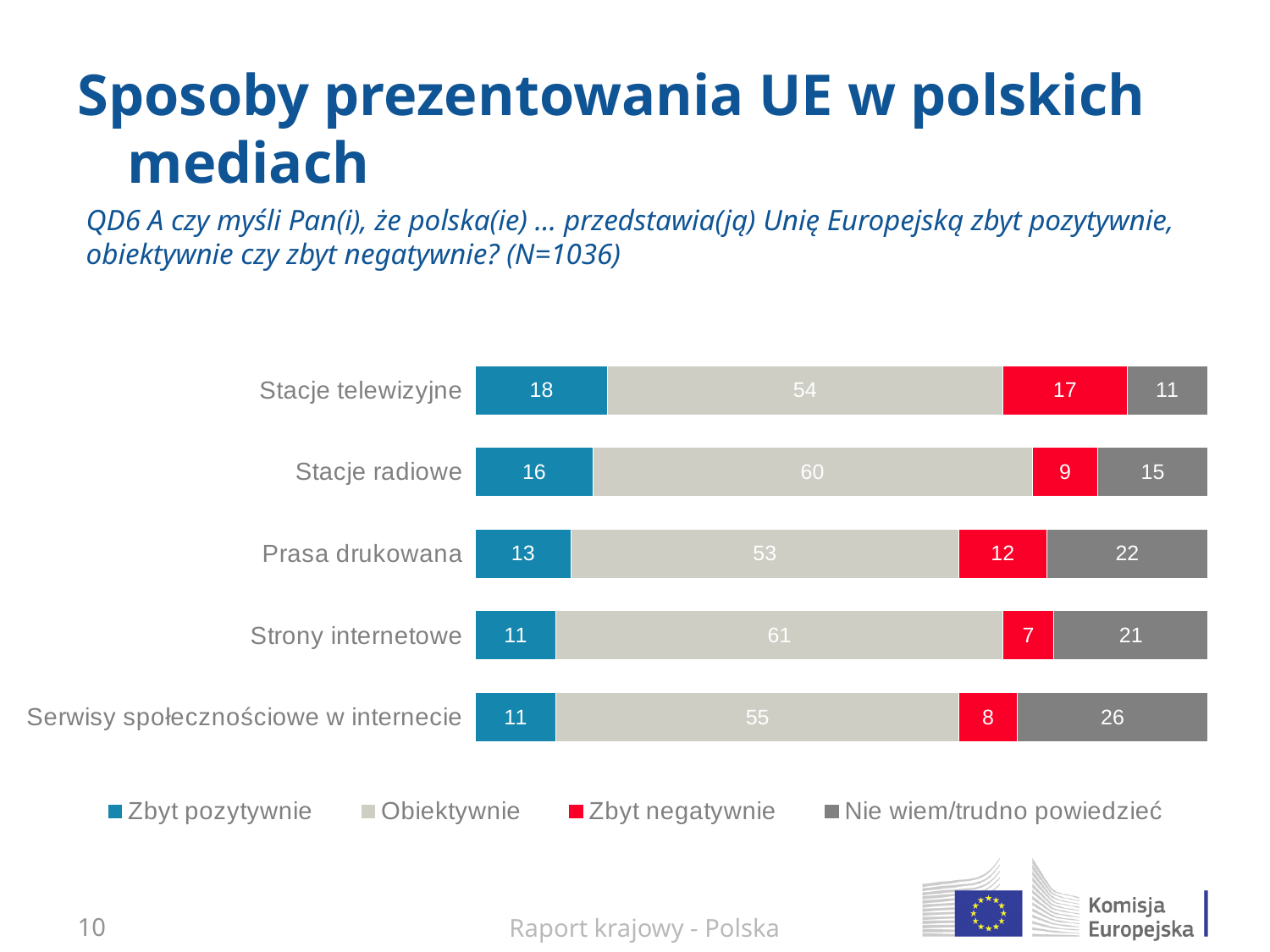
Which category has the lowest value for "Zbyt negatywnie"? Strony internetowe Which category has the highest value for "Zbyt pozytywnie"? Stacje telewizyjne What is the value for "Obiektywnie" for Stacje radiowe? 60 How many series does the legend list? 4 How many categories are shown on the chart? 5 What is the total of the stacked bar for Stacje radiowe? 100 What is the value for "Nie wiem/trudno powiedzieć" for Serwisy społecznościowe w internecie? 26 What is the difference between the "Nie wiem/trudno powiedzieć" values for Serwisy społecznościowe w internecie and Stacje telewizyjne? 15 What kind of chart is shown on the slide? Stacked bar chart Which series is shown in red in the legend? Zbyt negatywnie Which is larger: the "Obiektywnie" value for Strony internetowe or for Prasa drukowana? Strony internetowe What is the value for "Zbyt negatywnie" for Stacje telewizyjne? 17